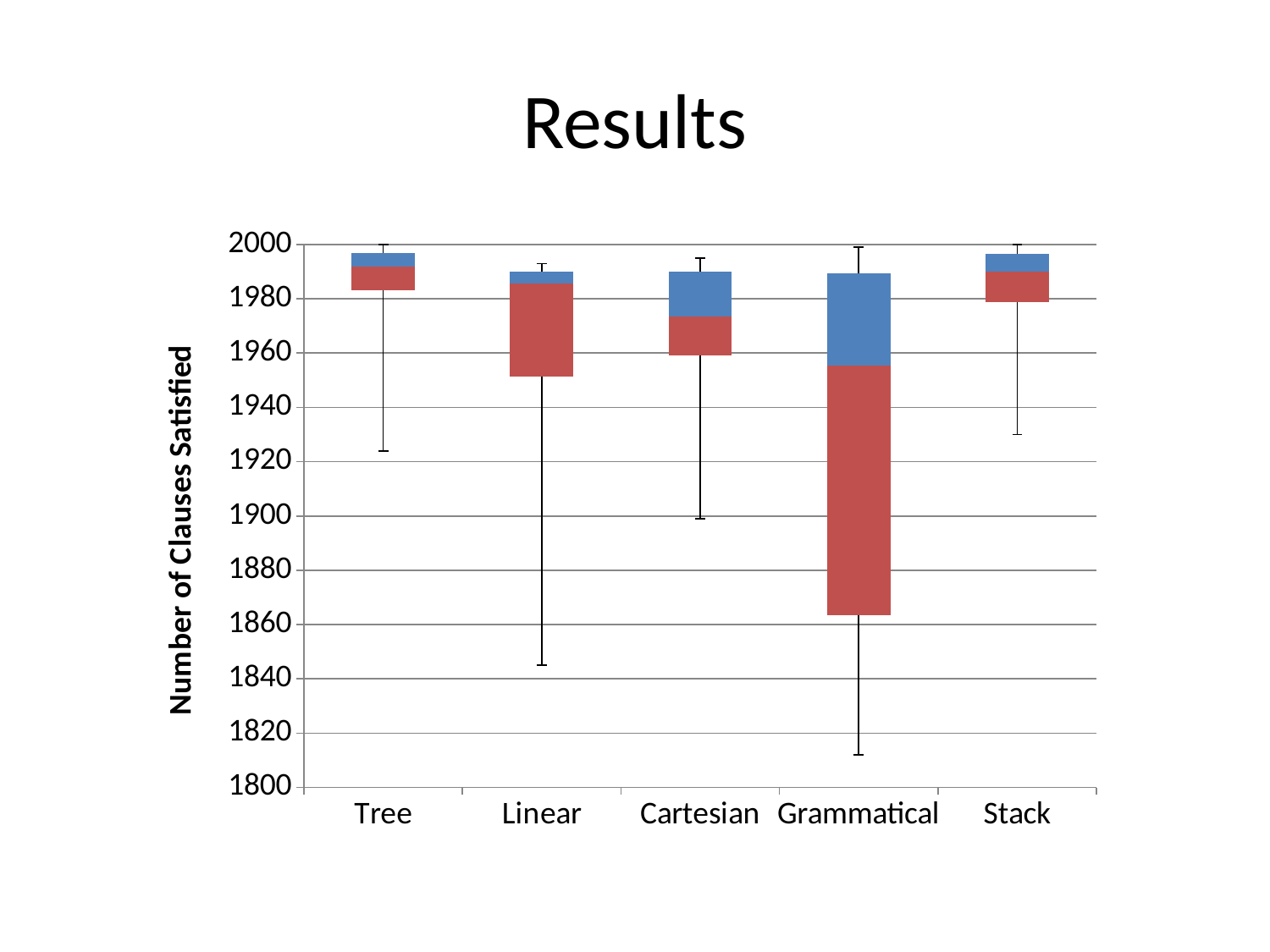
Is the bottom whisker for Stack greater or less than 1920? greater Which category has the tallest box (widest range between box top and bottom)? Grammatical What is the title of the chart's vertical axis? Number of Clauses Satisfied How many categories are shown on the x axis of the chart? 5 Which category has the lower bottom whisker, Linear or Grammatical? Grammatical Is the bottom whisker for Grammatical greater or less than 1820? less Is the bottom whisker for Linear greater or less than 1860? less What kind of chart is shown on the slide? Box-and-whisker chart What is the title of the slide? Results Which category has the lowest bottom whisker? Grammatical